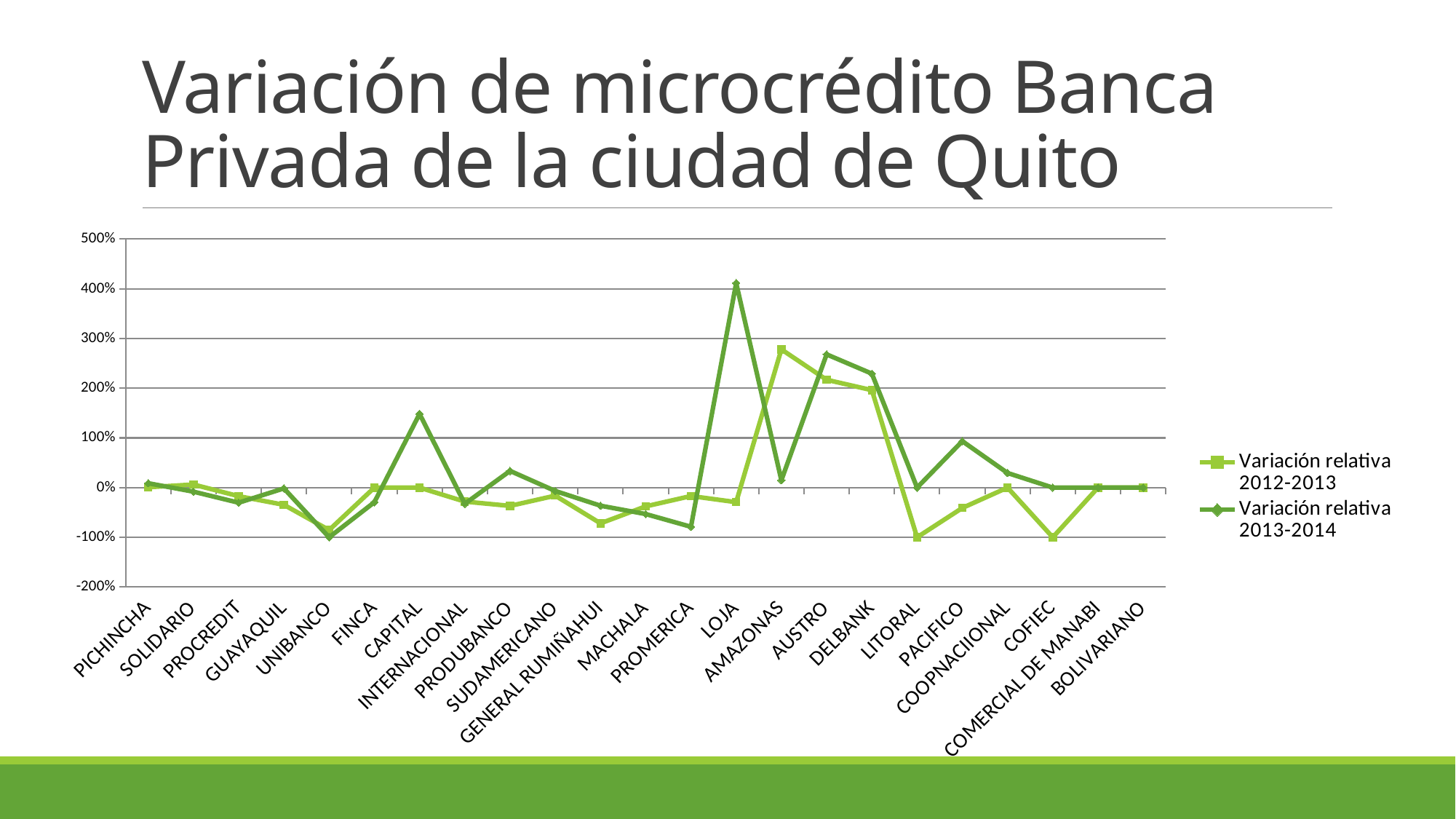
How many series does the legend list? 2 Which bank has the lowest value for the Variación relativa 2013-2014 series? UNIBANCO What kind of chart is shown on the slide? Line chart Is the Variación relativa 2013-2014 value for LOJA greater or less than 300%? greater How many banks (categories) are plotted along the x axis? 23 Is the Variación relativa 2013-2014 value for CAPITAL greater or less than 100%? greater For LOJA, which series has the larger value: Variación relativa 2012-2013 or Variación relativa 2013-2014? Variación relativa 2013-2014 Which bank has the highest value for the Variación relativa 2013-2014 series? LOJA What is the title of the slide containing the chart? Variación de microcrédito Banca Privada de la ciudad de Quito Is the Variación relativa 2012-2013 value for LITORAL greater or less than 0%? less Which bank has the highest value for the Variación relativa 2012-2013 series? AMAZONAS